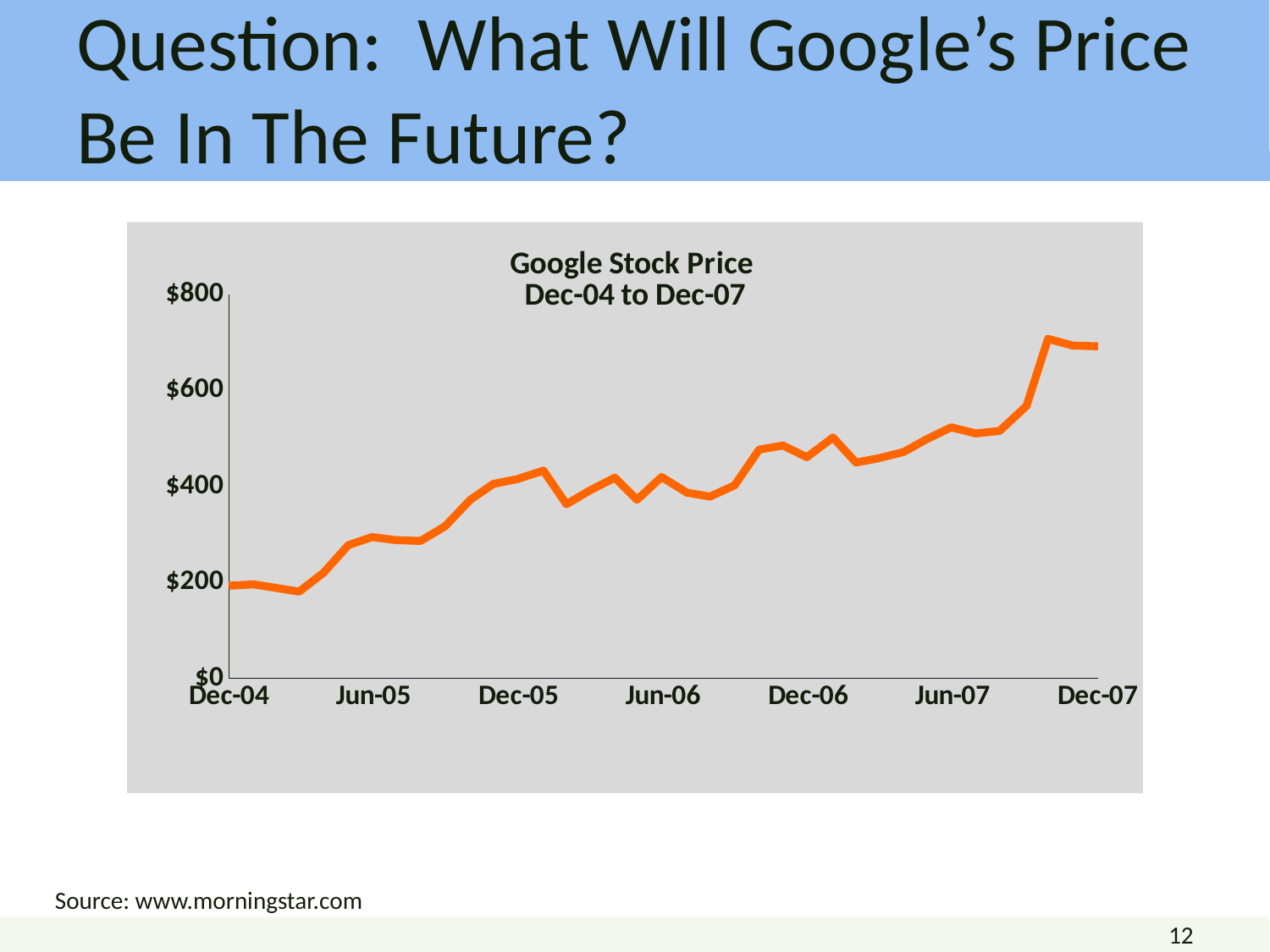
Is the stock price at Dec-06 greater or less than $600? less Among the dates labeled on the x axis, at which is the stock price lowest? Dec-04 Is the stock price at Dec-05 greater or less than $200? greater Among the dates labeled on the x axis, at which is the stock price highest? Dec-07 What kind of chart is shown on the slide? line chart Is the stock price higher at Jun-06 or at Jun-07? Jun-07 What is the title of the chart? Google Stock Price Dec-04 to Dec-07 Is the stock price at Jun-07 greater or less than $400? greater What is the highest value shown on the y axis? $800 Overall, does Google's stock price rise or fall from Dec-04 to Dec-07? rise